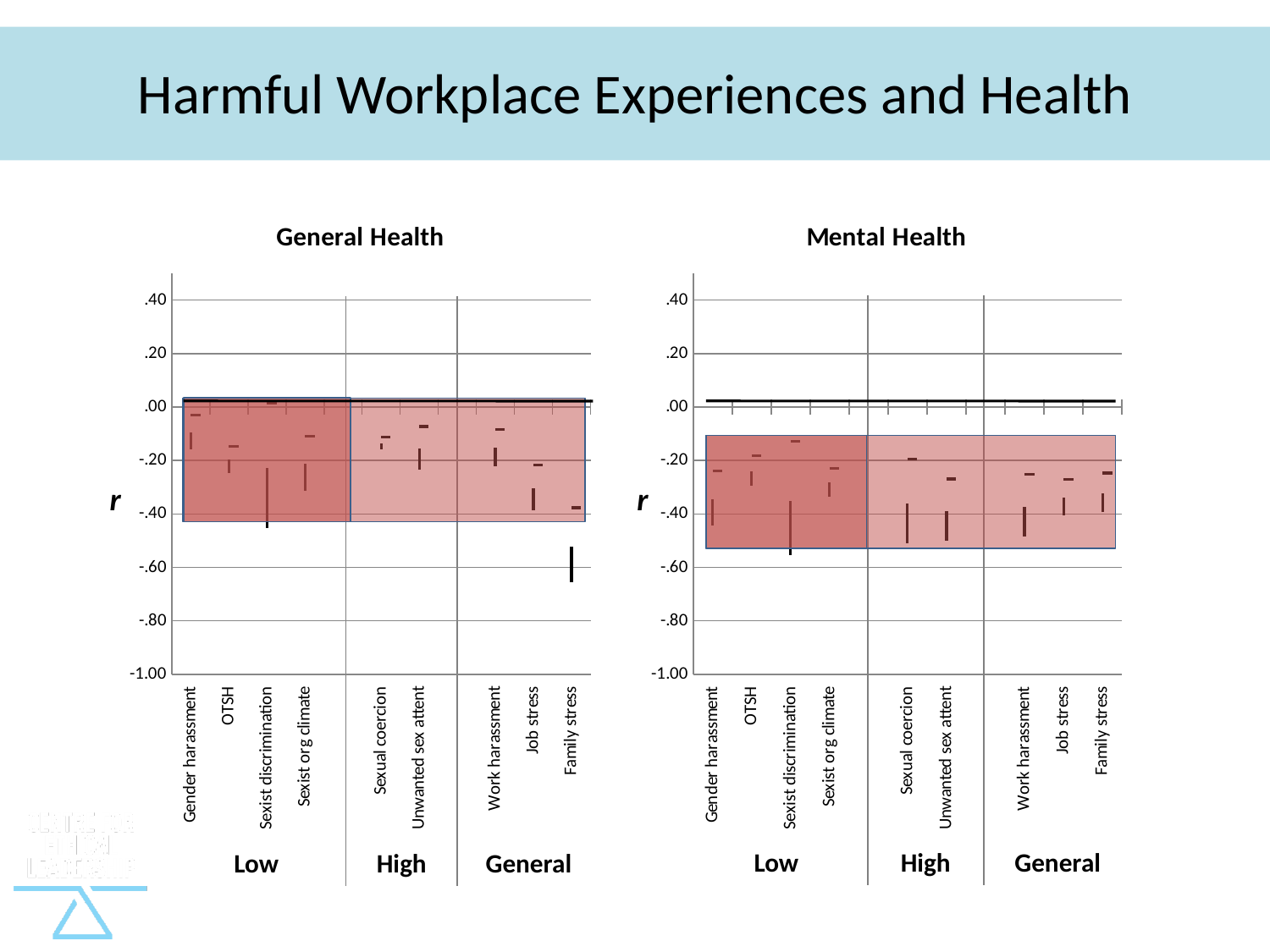
In the General Health chart, is the value for Work harassment greater or less than .00? less In the Mental Health chart, is the value for Unwanted sex attent greater or less than -.20? less In the General Health chart, how many categories are shown along the x axis? 9 What is the title of the right chart? Mental Health In the General Health chart, what is the lowest value shown on the y axis? -1.00 In the Mental Health chart, how many categories are grouped under the 'Low' label? 4 What is the title of the left chart? General Health In the Mental Health chart, is the value for Sexist org climate greater or less than -.40? greater In the General Health chart, how many categories are grouped under the 'High' label? 2 In the Mental Health chart, which category has a higher value, OTSH or Unwanted sex attent? OTSH